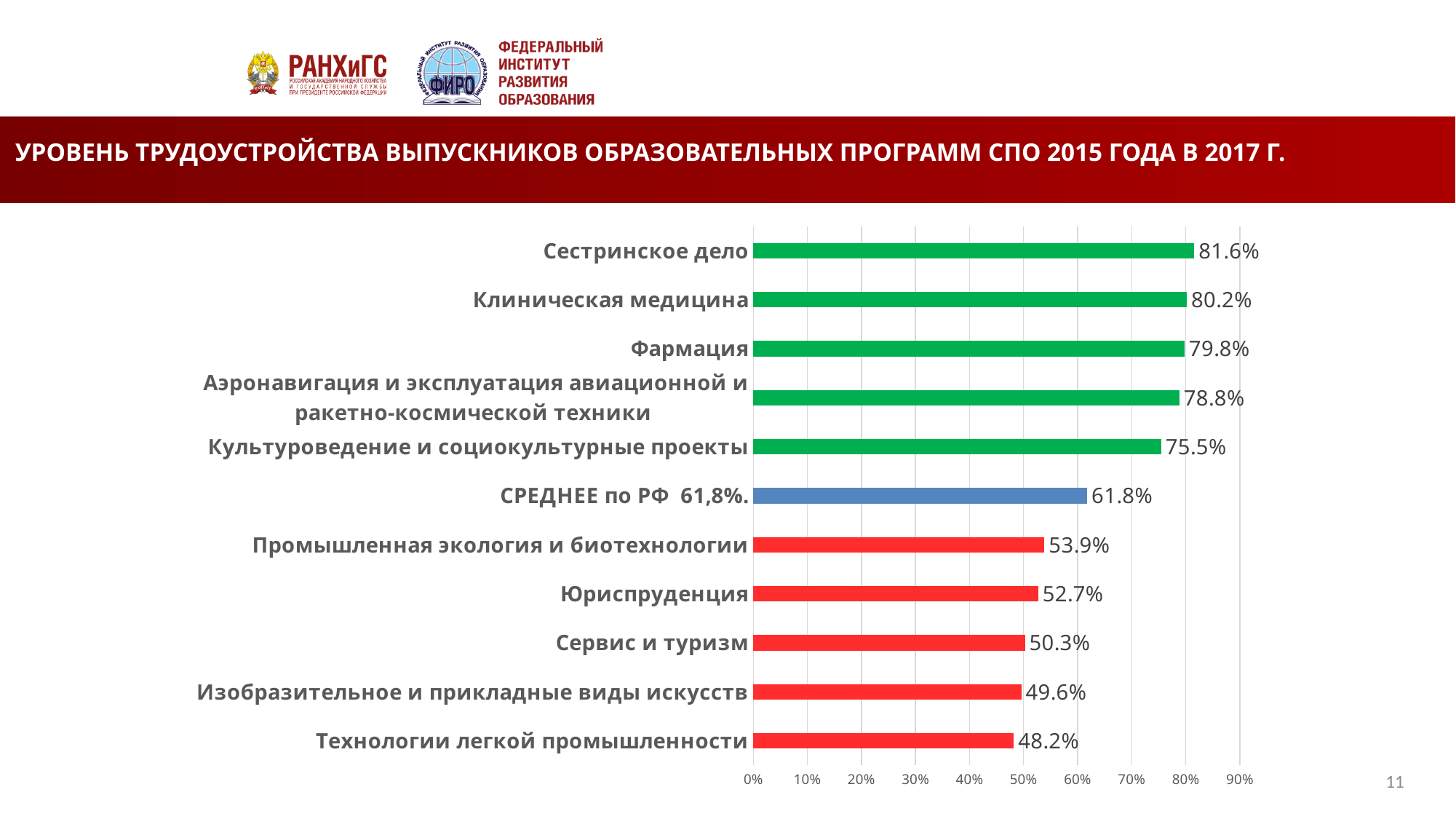
What value is shown for Юриспруденция? 52.7% Is the value for Культуроведение и социокультурные проекты greater or less than 70%? greater What value is shown for СРЕДНЕЕ по РФ? 61.8% What type of chart is shown on the slide? bar chart What is the difference between the values for Сестринское дело and Технологии легкой промышленности? 33.4% Which category has the lowest value on the chart? Технологии легкой промышленности Which category has the highest value on the chart? Сестринское дело What is the employment rate shown for Сестринское дело? 81.6% Which is larger, the value for Фармация or the value for Сервис и туризм? Фармация What colour is the bar for СРЕДНЕЕ по РФ? blue How many bars are coloured red? 5 How many categories (bars) are shown on the chart? 11